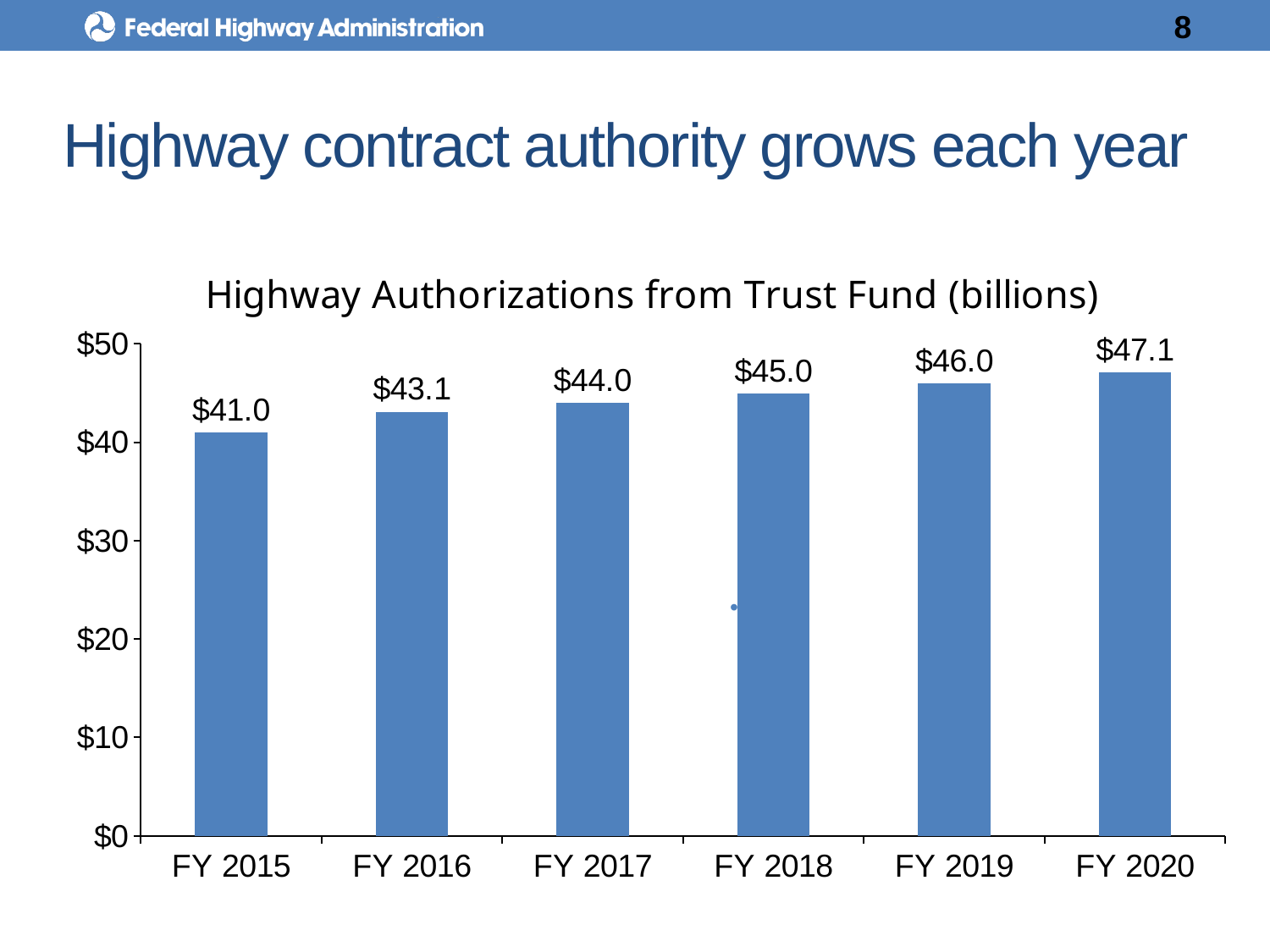
Is the value for FY 2016 greater or less than $40? greater What is the value for FY 2015? $41.0 Which fiscal year has the lowest value? FY 2015 What kind of chart is shown on the slide? bar chart What is the difference between the values for FY 2020 and FY 2015? $6.1 What is the difference between the values for FY 2016 and FY 2015? $2.1 What is the value for FY 2018? $45.0 Which is larger, the value for FY 2017 or the value for FY 2019? FY 2019 What is the value for FY 2020? $47.1 Which fiscal year has the highest value? FY 2020 How many fiscal years are shown on the x axis? 6 Do the values rise or fall from FY 2015 to FY 2020? rise